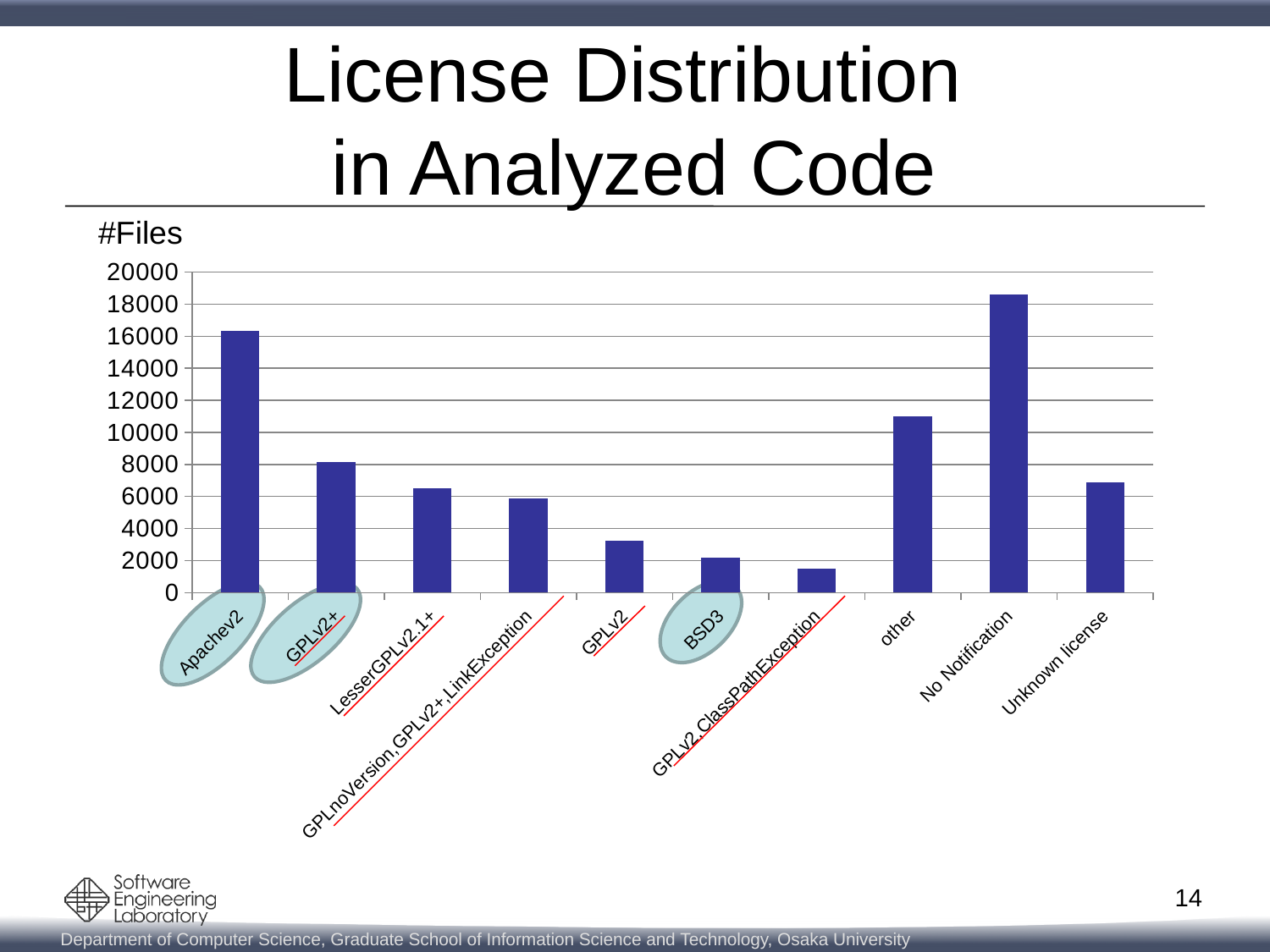
Is the value for BSD3 greater or less than 4000? less Is the value for Apachev2 greater or less than 14000? greater Is the value for No Notification greater or less than 18000? greater Which has more files, Apachev2 or other? Apachev2 How many license categories are plotted on the chart? 10 Which category has the highest number of files? No Notification Which category has the lowest number of files? GPLv2,ClassPathException Which has more files, GPLv2 or Unknown license? Unknown license What label is shown above the vertical axis of the chart? #Files What kind of chart is shown on the slide? bar chart